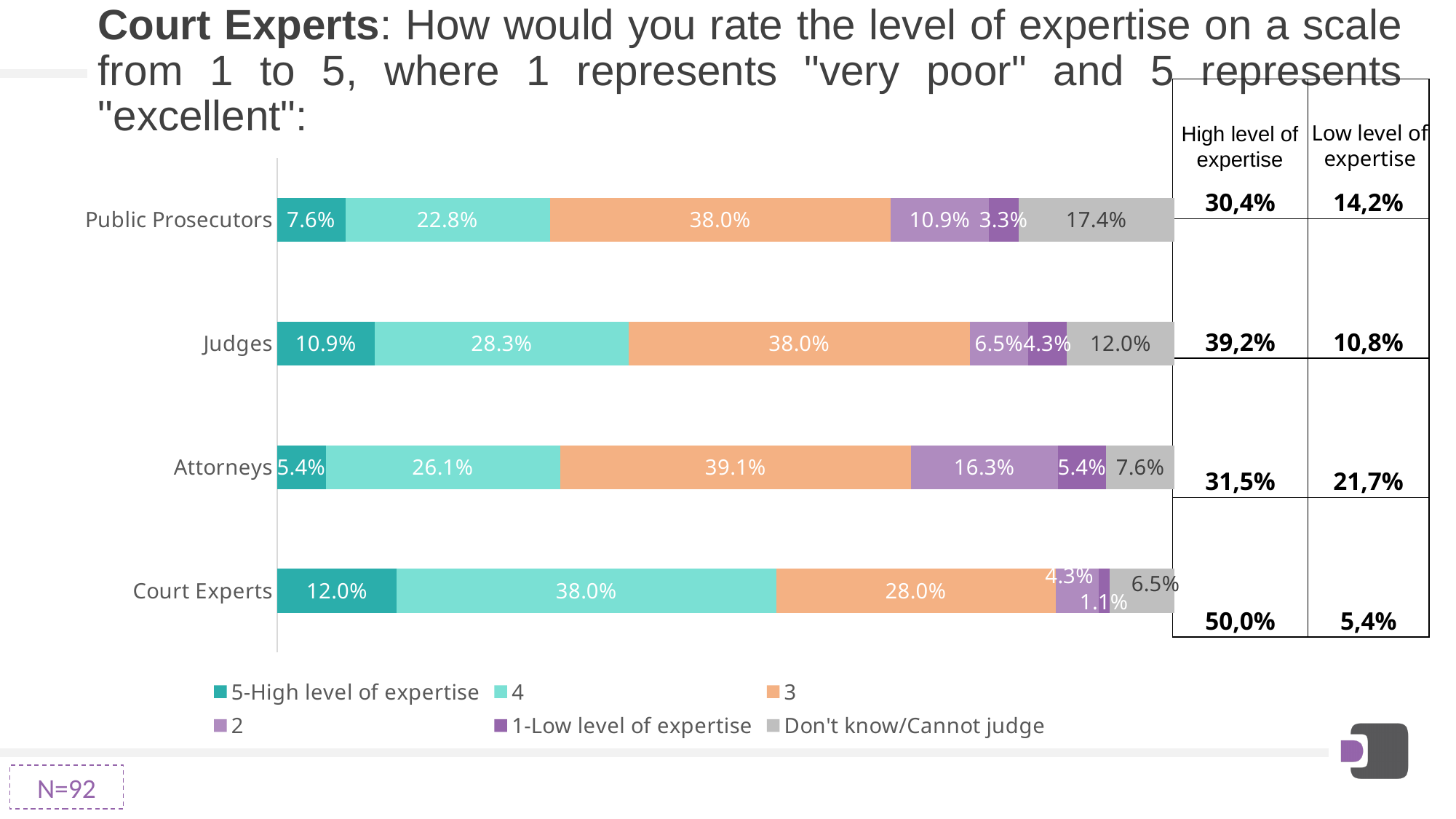
Which is larger: the 'Don't know/Cannot judge' value for Public Prosecutors or for Judges? Public Prosecutors What kind of chart is shown on the slide? Stacked bar chart What percentage of respondents rated Court Experts with a 4? 38.0% Which category has the lowest 'Don't know/Cannot judge' value? Court Experts How many series does the legend list? 6 What is the value for Judges in the '5-High level of expertise' series? 10.9% Which category has the highest value in the '2' series? Attorneys Which category has the highest value in the '5-High level of expertise' series? Court Experts What is the difference between the '4' values for Judges and Public Prosecutors? 5.5 percentage points How many categories are shown on the chart? 4 What is the 'Don't know/Cannot judge' value for Attorneys? 7.6% What percentage of respondents rated Public Prosecutors with a 3? 38.0%